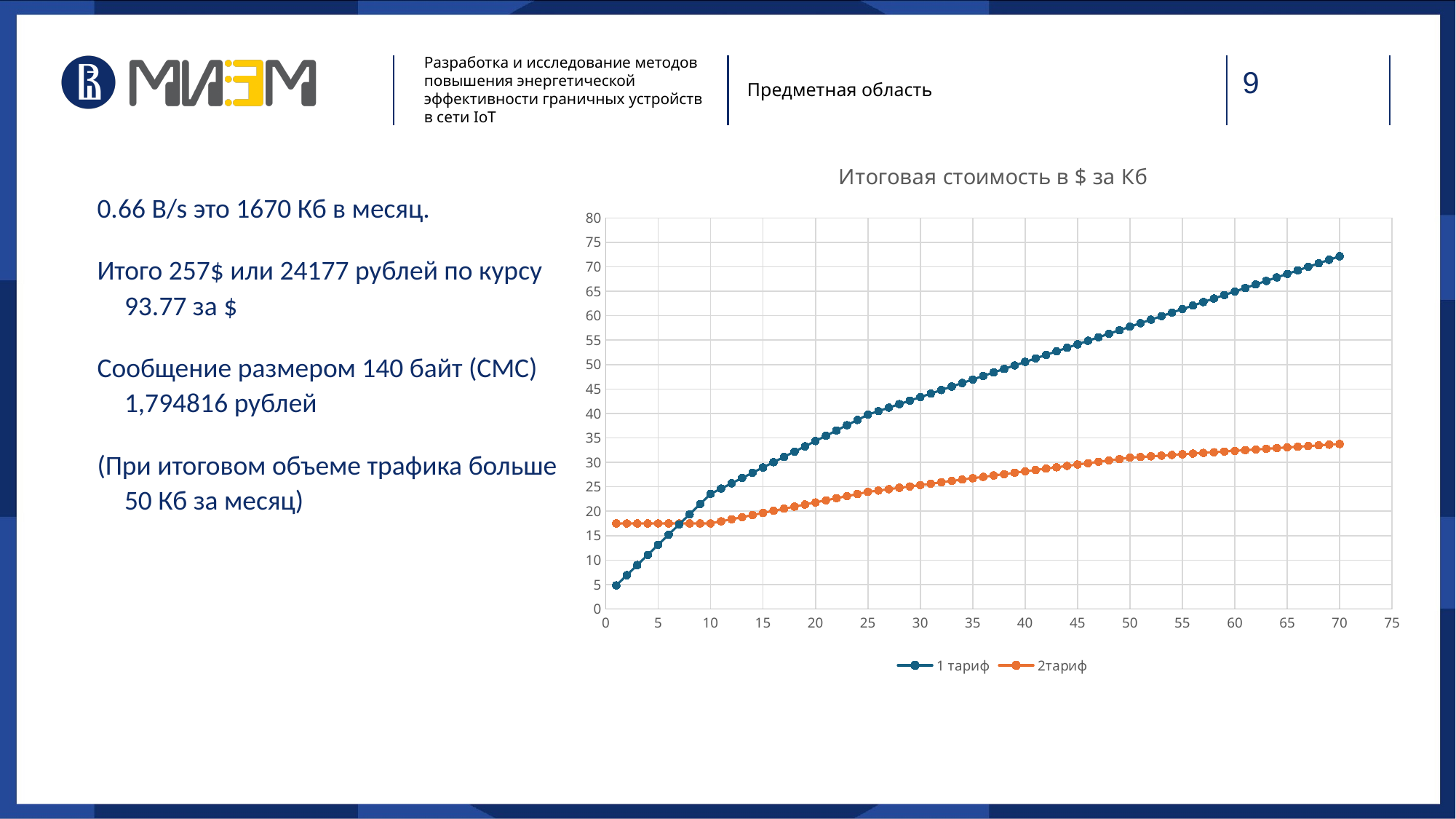
Do the values of the 1 тариф series rise or fall as the x axis increases? rise Is the value of 1 тариф at x = 70 greater or less than 60? greater How many series does the chart legend list? 2 Do the values of the 2тариф series rise or fall as the x axis increases? rise Is the value of 1 тариф at x = 1 greater or less than 10? less Is the value of 2тариф at x = 70 greater or less than 35? less At x = 1, which series has the larger value, 1 тариф or 2тариф? 2тариф What kind of chart is shown on the slide? line chart Which series is drawn in orange in the chart? 2тариф At x = 70, which series has the larger value, 1 тариф or 2тариф? 1 тариф What is the title of the chart? Итоговая стоимость в $ за Кб